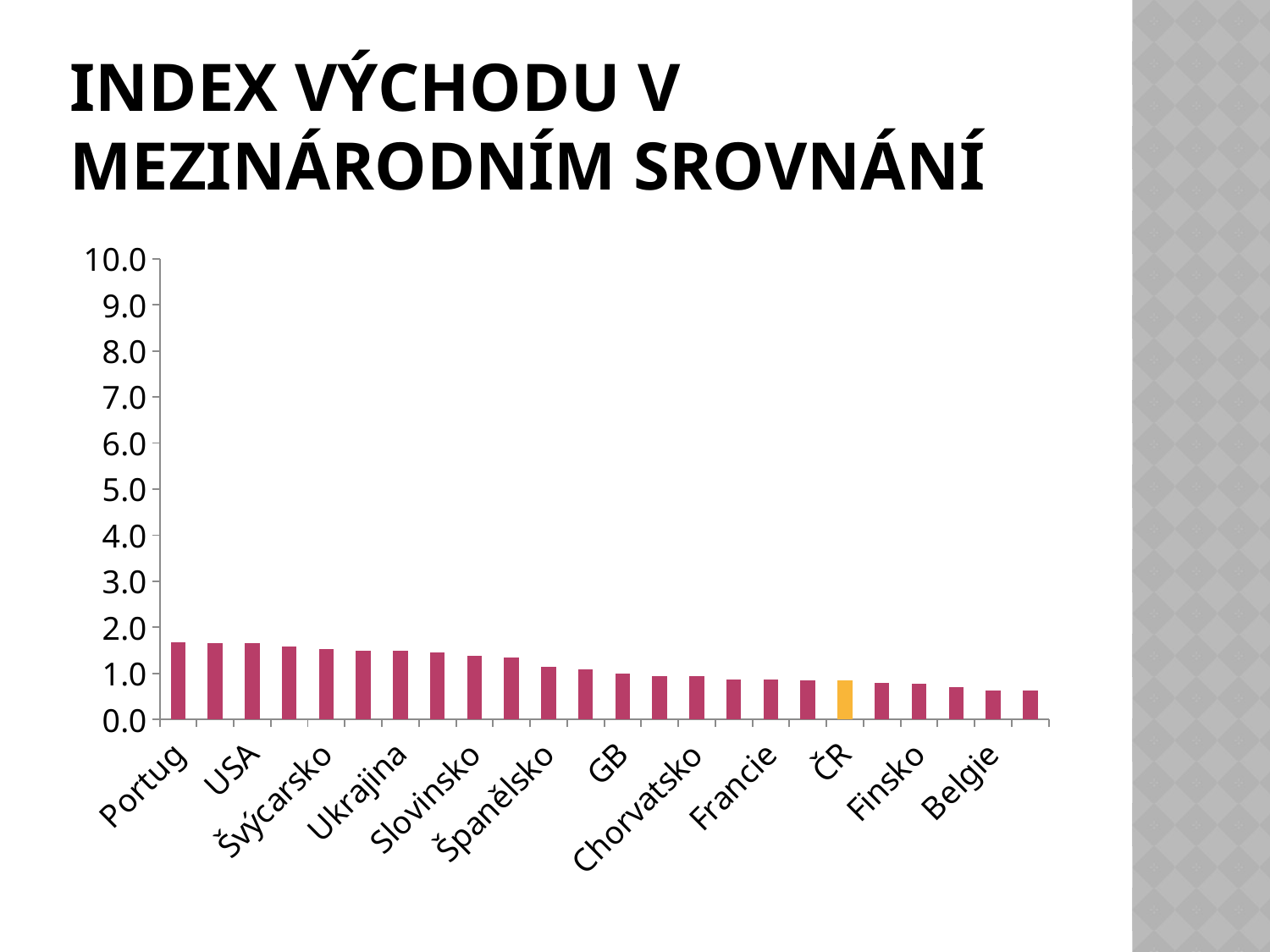
Which bar is highlighted in a different colour (yellow) from the others? ČR Is the value for Portug greater or less than 1.0? greater Which has the larger value, Portug or Belgie? Portug What kind of chart is shown on the slide? bar chart Do the values rise or fall from left to right along the x axis? fall Is the value for ČR greater or less than 1.0? less Which has the larger value, Ukrajina or ČR? Ukrajina Is the value for Belgie greater or less than 1.0? less What is the title of the chart on the slide? Index východu v mezinárodním srovnání